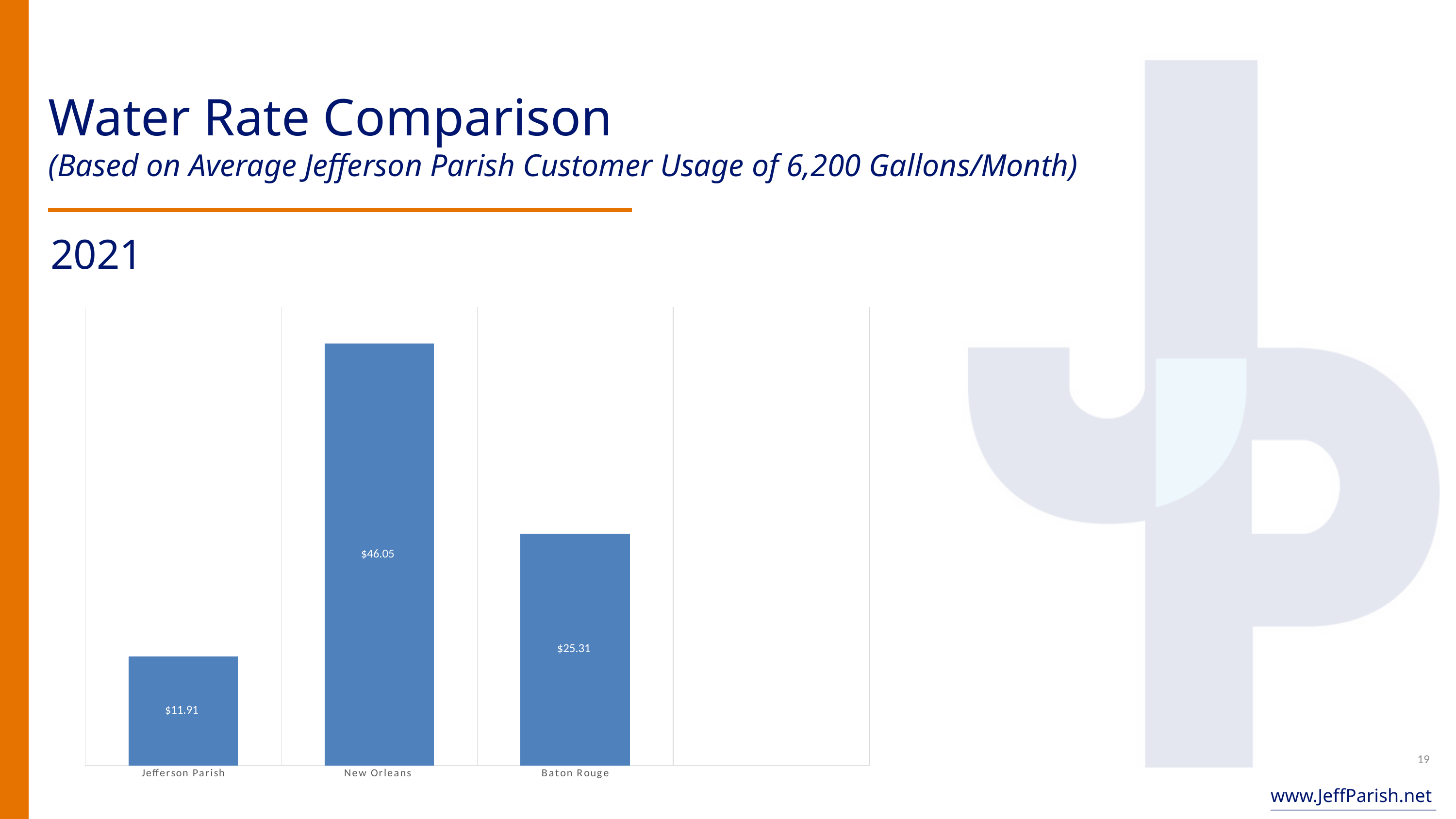
Which category has the lowest water rate? Jefferson Parish How many categories are shown in the chart? 3 Which has a higher water rate, Baton Rouge or Jefferson Parish? Baton Rouge What is the water rate shown for New Orleans? $46.05 What monthly usage is the water rate comparison based on? 6,200 Gallons/Month What is the water rate shown for Jefferson Parish? $11.91 What is the difference between the New Orleans and Jefferson Parish water rates? $34.14 Which category has the highest water rate? New Orleans What is the water rate shown for Baton Rouge? $25.31 What kind of chart is shown on the slide? Bar chart What is the difference between the Baton Rouge and Jefferson Parish water rates? $13.40 What year does the chart's data represent? 2021